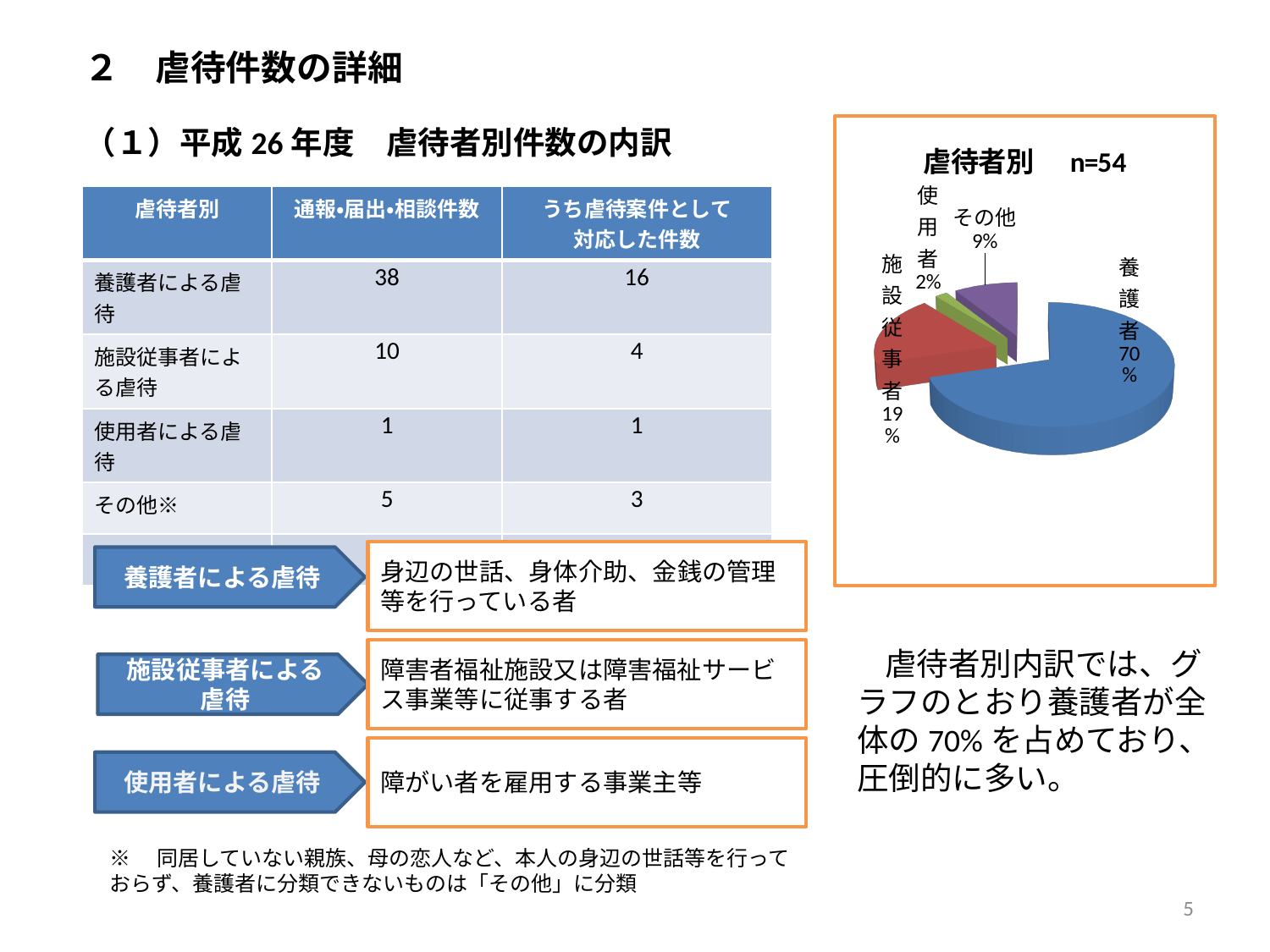
How many slices does the pie chart have? 4 What share of the pie chart does 使用者 account for? 2% What kind of chart is shown on the slide? pie chart Which category has the smallest slice in the pie chart? 使用者 What is the title of the pie chart? 虐待者別 What is the difference in percentage points between the 養護者 slice and the 施設従事者 slice? 51 Which category has the largest slice in the pie chart? 養護者 What share of the pie chart does 施設従事者 account for? 19% What share of the pie chart does その他 account for? 9% What is the value of n shown next to the pie chart title? n=54 In the pie chart, which is larger: 施設従事者 or その他? 施設従事者